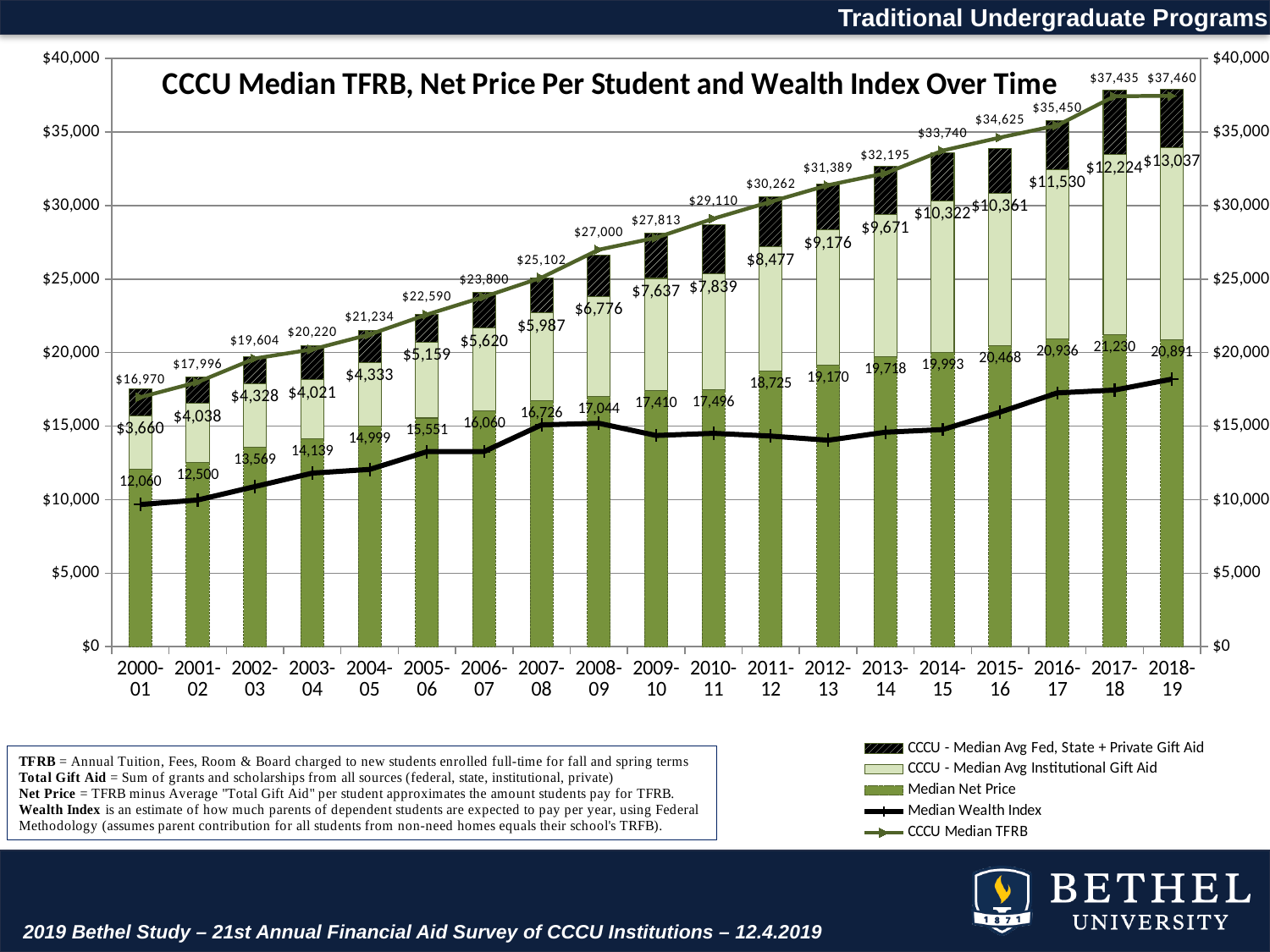
Is the Median Wealth Index for 2018-19 greater or less than $15,000? greater What is the CCCU Median TFRB for 2018-19? $37,460 By how much did the CCCU Median TFRB increase from 2000-01 to 2018-19? $20,490 What is the Median Net Price for 2005-06? 15,551 How many series does the legend list? 5 In which year is the Median Net Price highest? 2017-18 In which year is the CCCU Median Avg Institutional Gift Aid lowest? 2000-01 How many academic years are shown on the x axis? 19 What is the difference in CCCU Median Avg Institutional Gift Aid between 2018-19 and 2017-18? $813 Does the CCCU Median TFRB rise or fall from 2000-01 to 2018-19? rise What is the CCCU Median Avg Institutional Gift Aid for 2010-11? $7,839 Which year has the larger Median Net Price, 2017-18 or 2018-19? 2017-18